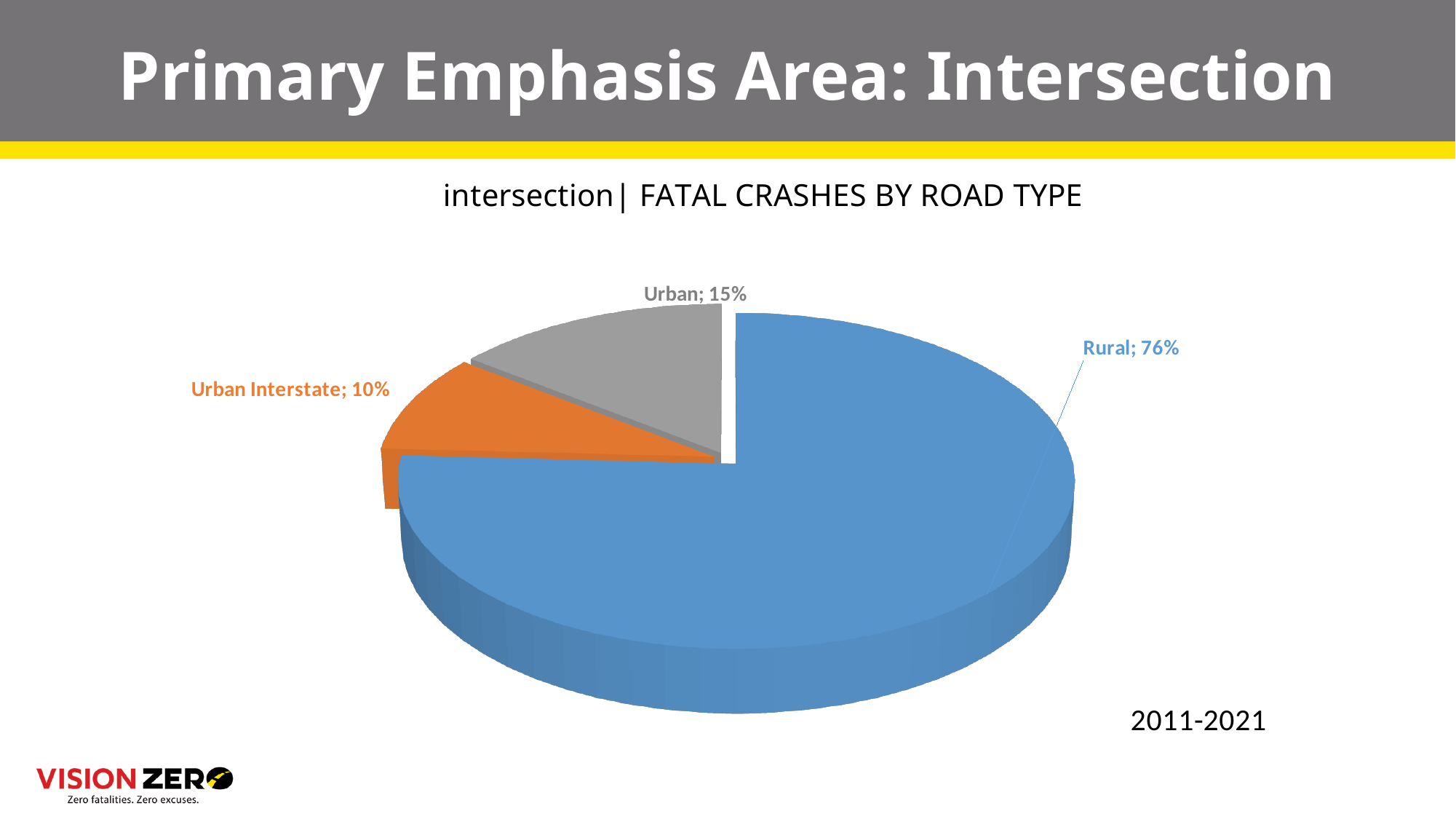
How many road type categories are shown in the pie chart? 3 What share of intersection fatal crashes occurred on Urban Interstate roads? 10% How many percentage points larger is the Rural share than the Urban share? 61 What share of intersection fatal crashes occurred on Urban roads? 15% Which road type has the largest share of intersection fatal crashes? Rural Which has a larger share of intersection fatal crashes, Urban or Urban Interstate? Urban What is the title of the chart? intersection| FATAL CRASHES BY ROAD TYPE How many percentage points larger is the Urban share than the Urban Interstate share? 5 What time period does the chart cover? 2011-2021 What share of intersection fatal crashes occurred on Rural roads? 76% Which road type has the smallest share of intersection fatal crashes? Urban Interstate What kind of chart is shown on the slide? Pie chart